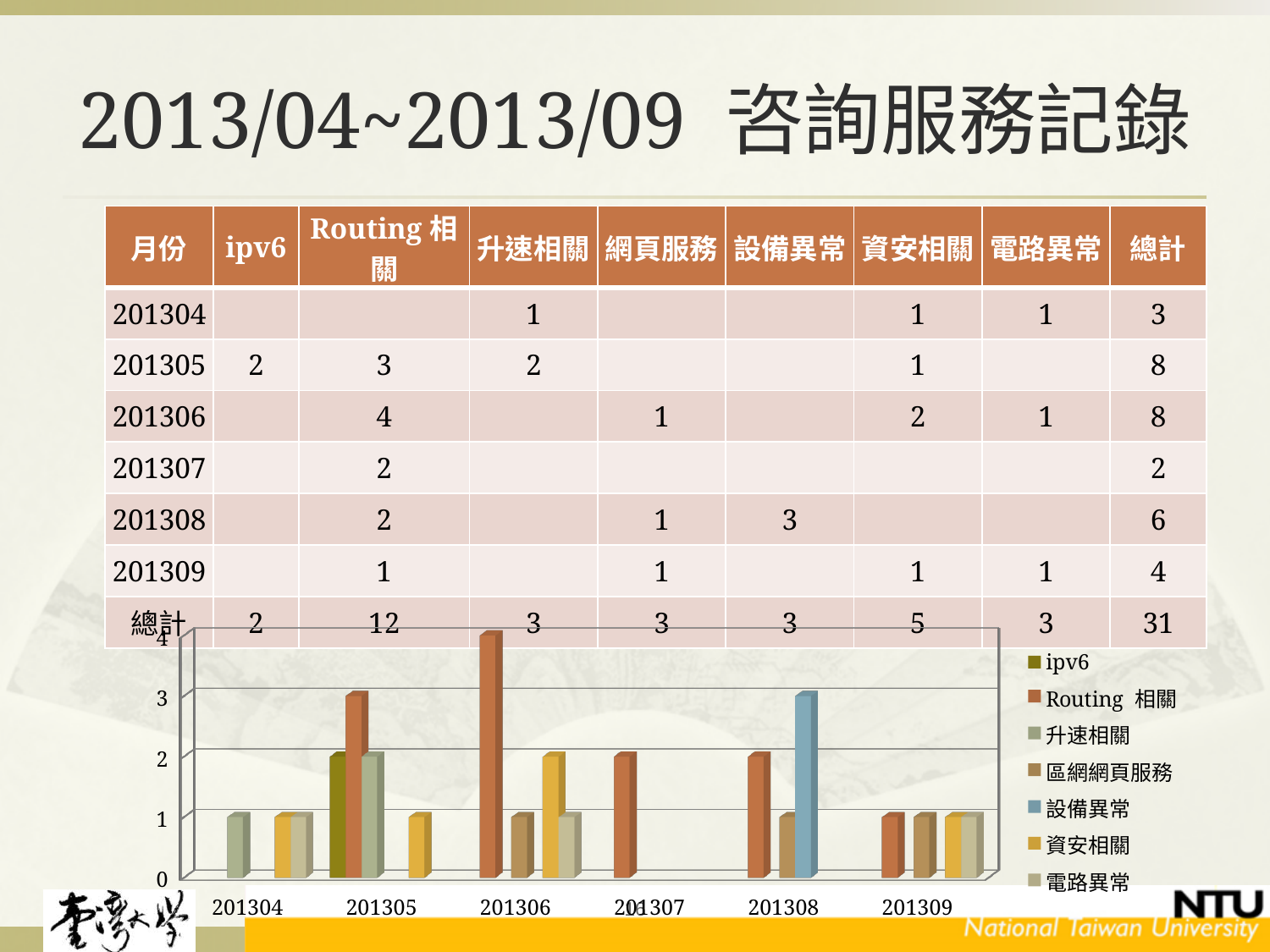
In the chart, which is larger for 201305: Routing 相關 or 升速相關? Routing 相關 How many series does the chart's legend list? 7 In the chart, which month has the tallest bar overall? 201306 What kind of chart is shown at the bottom of the slide? bar chart In the chart, which month has the fewest bars plotted? 201307 In the chart, is the value of Routing 相關 for 201305 greater or less than 2? greater In the chart, what is the value of 設備異常 for 201308? 3 In the chart, what is the difference between Routing 相關 for 201306 and Routing 相關 for 201309? 3 In the chart, what is the value of Routing 相關 for 201306? 4 What is the highest value shown on the chart's vertical axis? 4 In the chart, what is the value of ipv6 for 201305? 2 How many month categories are shown along the x axis of the chart? 6